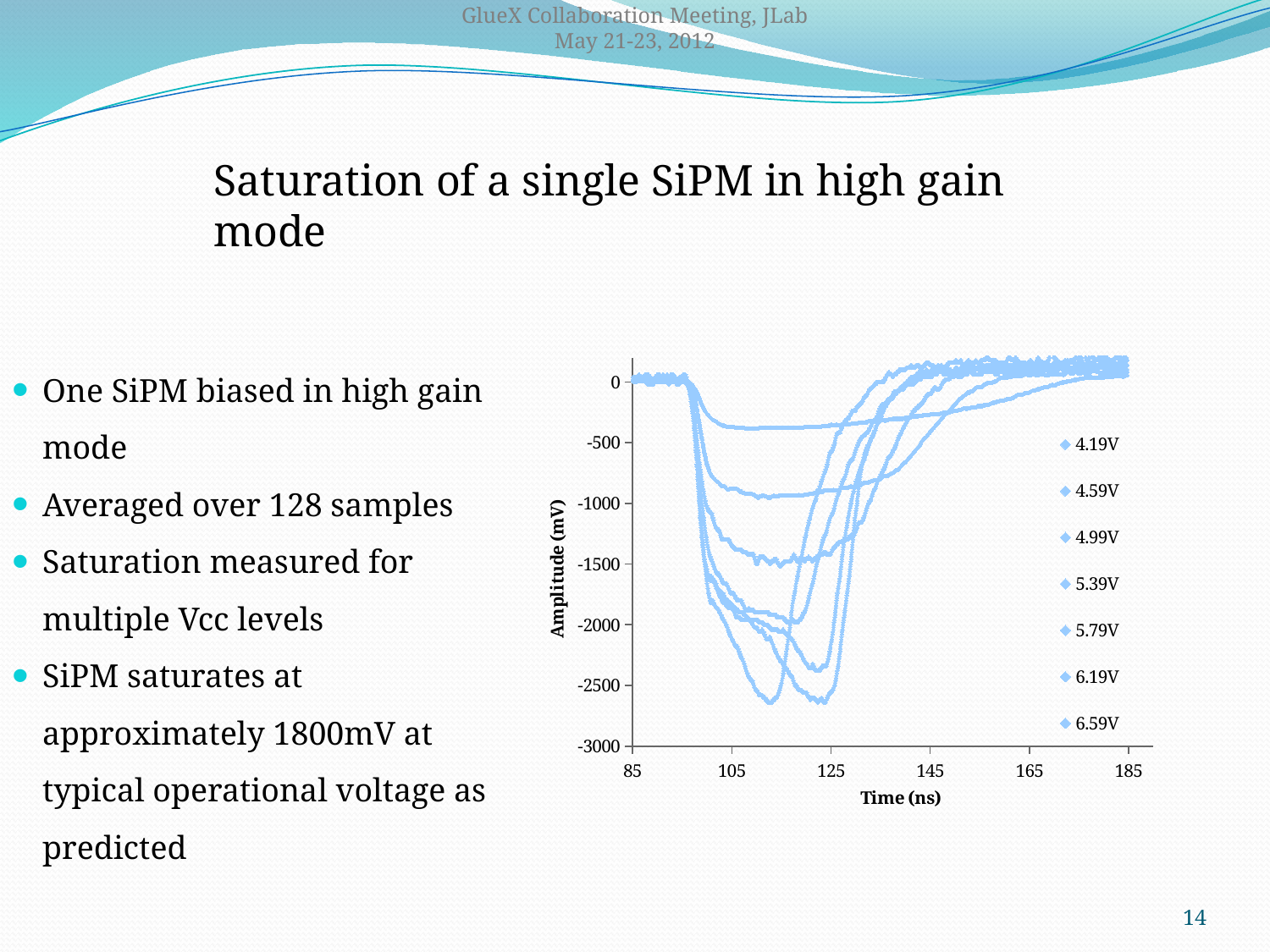
What kind of chart is shown on the slide? scatter chart Does any curve on the chart reach an amplitude below -2500 mV? yes Does any curve on the chart reach an amplitude below -3000 mV? no How many series does the legend of the chart list? 7 What is the label of the y axis of the chart? Amplitude (mV) Do the amplitudes on the chart rise or fall sharply just after about 95 ns? fall What is the label of the x axis of the chart? Time (ns) Do the curves on the chart return toward 0 mV by 185 ns? yes